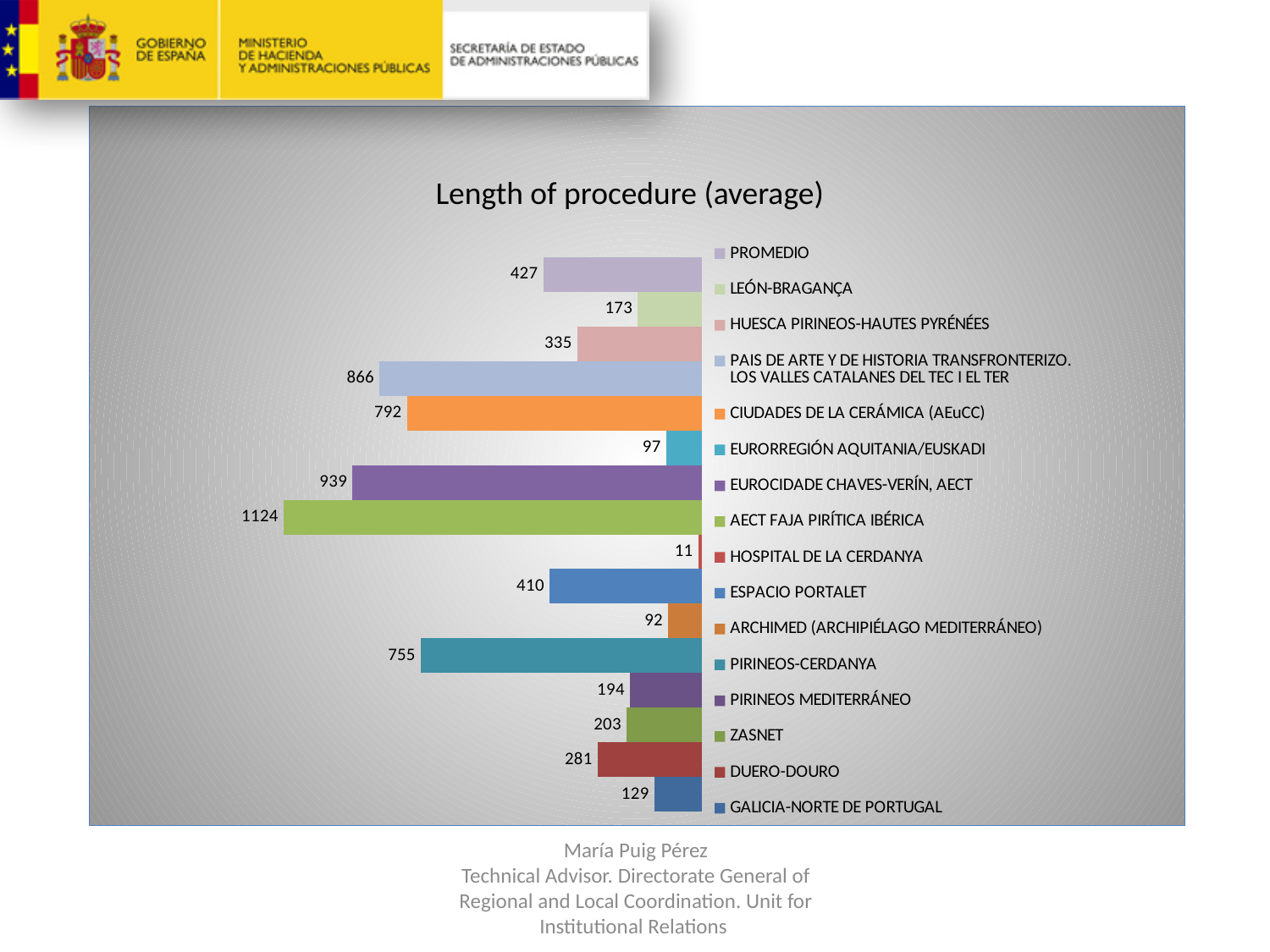
What is the value for PROMEDIO? 427 What kind of chart is shown on the slide? Bar chart Which entry has the highest value? AECT FAJA PIRÍTICA IBÉRICA What is the value for GALICIA-NORTE DE PORTUGAL? 129 What is the title of the chart? Length of procedure (average) Which is larger, the value for ZASNET or the value for PIRINEOS MEDITERRÁNEO? ZASNET What is the difference between the values for EUROCIDADE CHAVES-VERÍN, AECT and PIRINEOS-CERDANYA? 184 Which entry has the lowest value? HOSPITAL DE LA CERDANYA How many entries does the legend list? 16 What is the value for CIUDADES DE LA CERÁMICA (AEuCC)? 792 Which is larger, the value for ESPACIO PORTALET or the value for HUESCA PIRINEOS-HAUTES PYRÉNÉES? ESPACIO PORTALET What is the value for AECT FAJA PIRÍTICA IBÉRICA? 1124